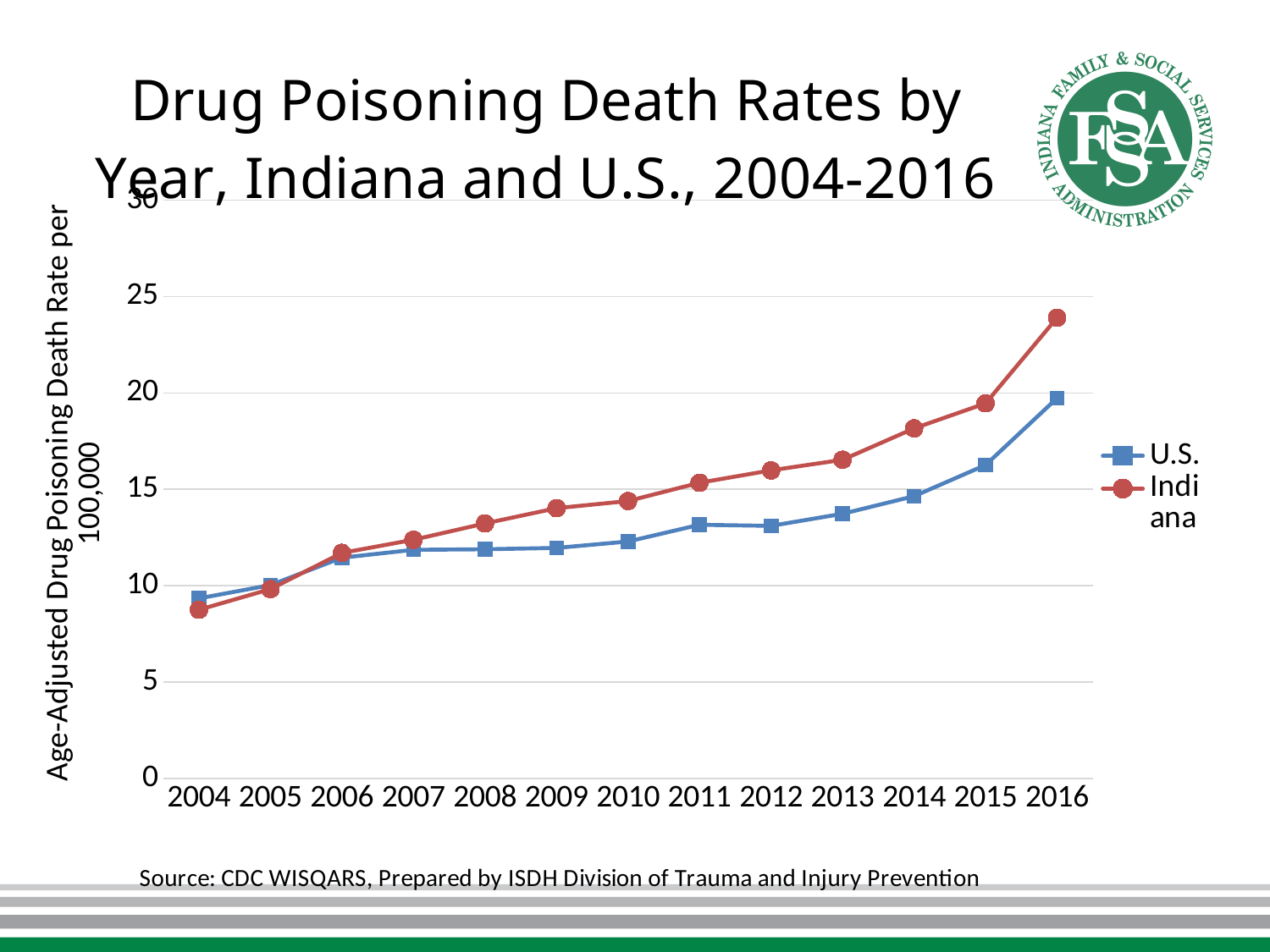
In which year is the Indiana drug poisoning death rate highest? 2016 How many years are plotted along the x axis? 13 In which year is the Indiana drug poisoning death rate lowest? 2004 Do the Indiana values generally rise or fall from 2004 to 2016? rise How many series does the legend list? 2 Is the Indiana value for 2016 greater or less than 20? greater Is the U.S. value for 2010 greater or less than 15? less In 2016, which series has the higher value, U.S. or Indiana? Indiana In 2004, which series has the higher value, U.S. or Indiana? U.S. Is the Indiana value for 2004 greater or less than 10? less What kind of chart is shown on the slide? line chart What is the label on the vertical axis? Age-Adjusted Drug Poisoning Death Rate per 100,000